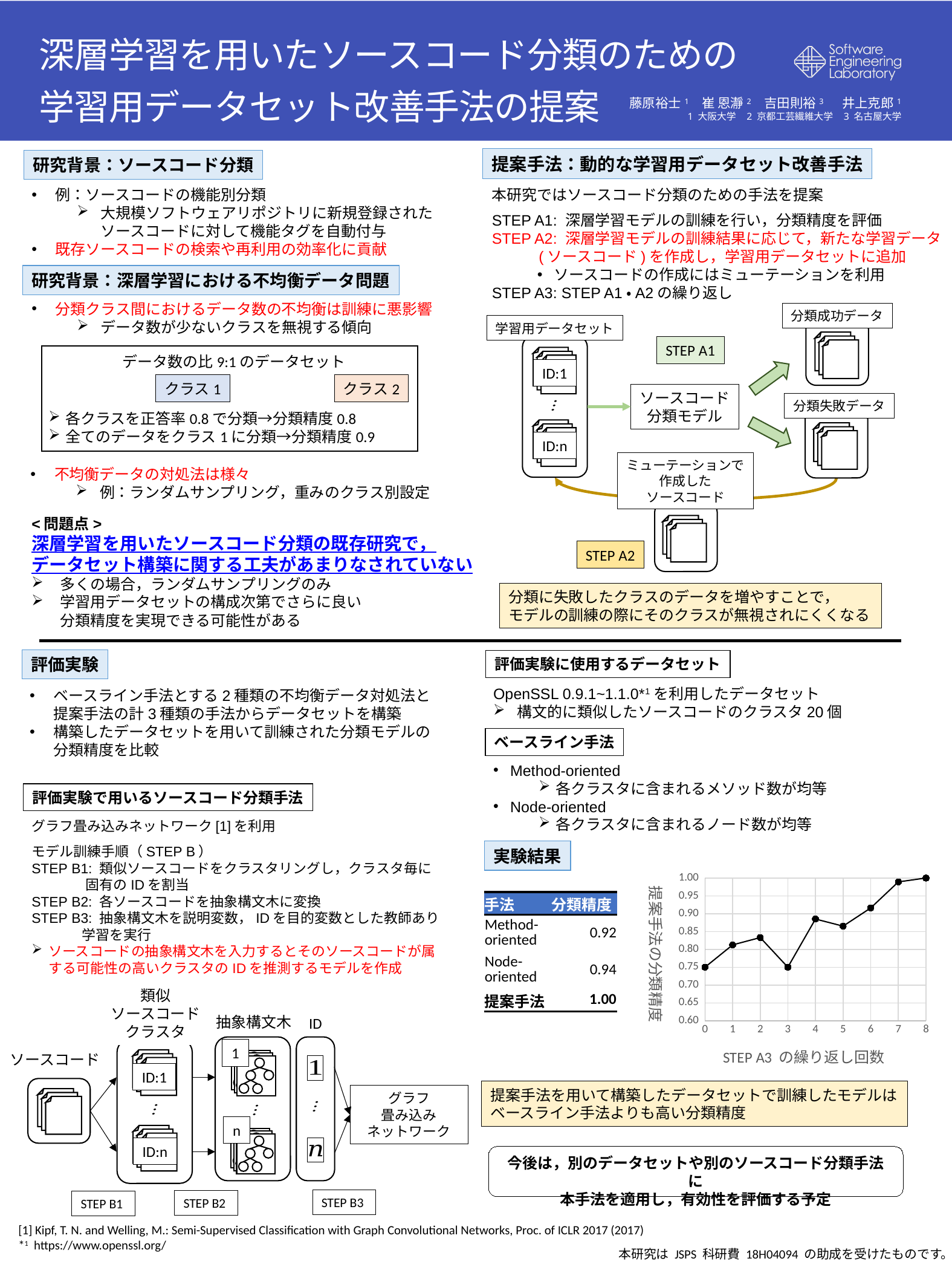
Is the value at 6 iterations greater or less than 0.90? greater What is the 提案手法の分類精度 at 8 iterations of STEP A3? 1.00 At which number of STEP A3 iterations is the 提案手法の分類精度 highest? 8 What kind of chart is shown in the 実験結果 section? line chart What is the 提案手法の分類精度 at 0 iterations of STEP A3? 0.75 Is the value at 7 iterations greater or less than 0.95? greater Is the value at 4 iterations greater or less than 0.85? greater How many data points are plotted on the line chart? 9 Overall, does the 提案手法の分類精度 rise or fall as the number of STEP A3 iterations increases? rise Which has the higher 分類精度: 3 iterations or 4 iterations? 4 iterations What is the label of the x axis of the line chart? STEP A3 の繰り返し回数